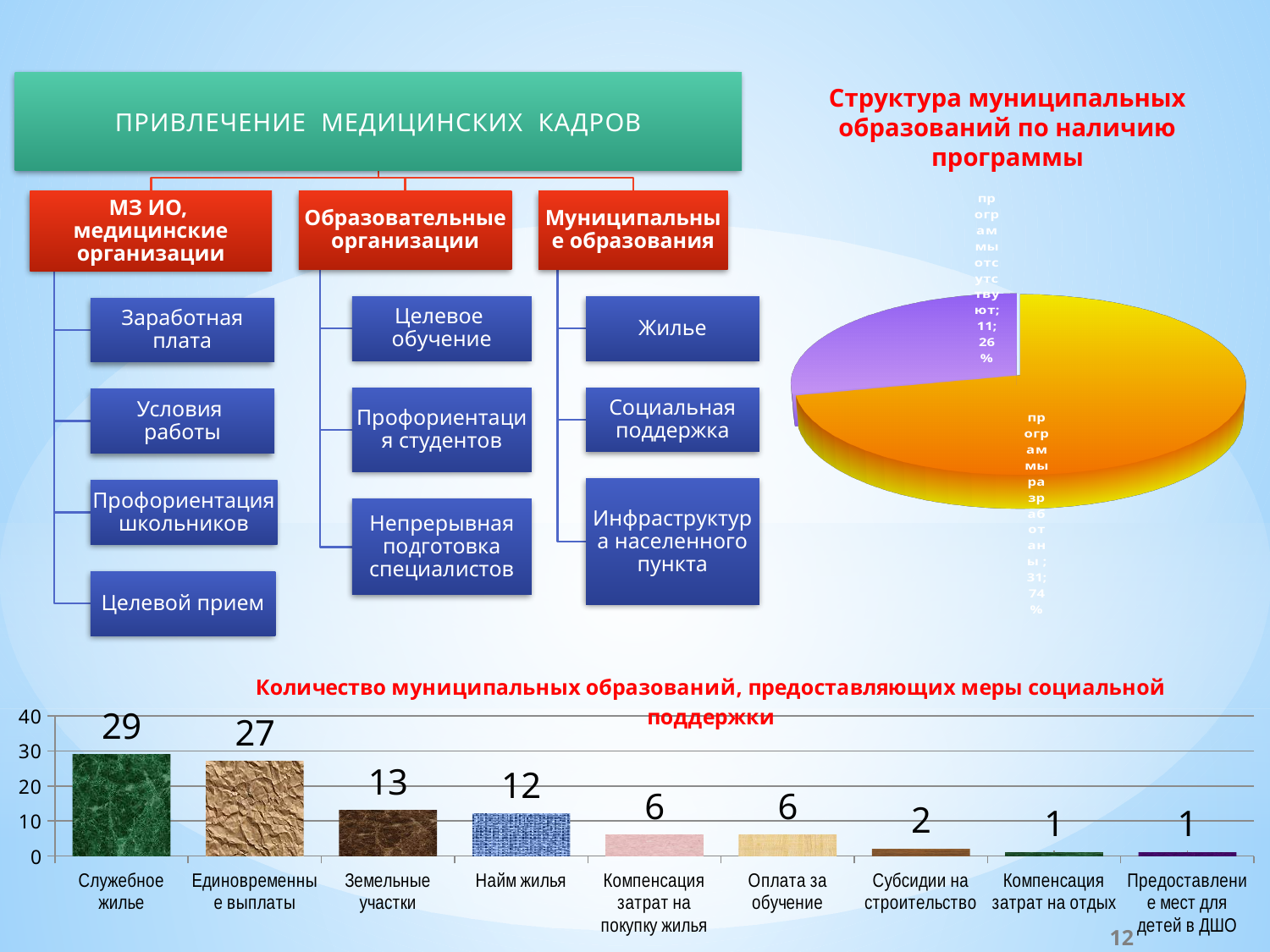
In the bar chart at the bottom of the slide, what is the value for 'Земельные участки'? 13 In the bar chart at the bottom of the slide, which is larger: 'Найм жилья' or 'Оплата за обучение'? Найм жилья In the pie chart 'Структура муниципальных образований по наличию программы', what share is shown for the purple slice 'программы отсутствуют'? 26% In the bar chart 'Количество муниципальных образований, предоставляющих меры социальной поддержки', what is the value for 'Служебное жилье'? 29 In the bar chart at the bottom of the slide, what is the difference between 'Земельные участки' and 'Найм жилья'? 1 In the bar chart at the bottom of the slide, what is the difference between 'Служебное жилье' and 'Единовременные выплаты'? 2 What kind of chart is the chart titled 'Структура муниципальных образований по наличию программы'? Pie chart In the bar chart at the bottom of the slide, do the values rise or fall from left to right? Fall In the bar chart at the bottom of the slide, how many categories are shown? 9 In the bar chart at the bottom of the slide, which category has the highest value? Служебное жилье In the bar chart at the bottom of the slide, what is the value for 'Субсидии на строительство'? 2 What kind of chart is the chart at the bottom of the slide? Bar chart